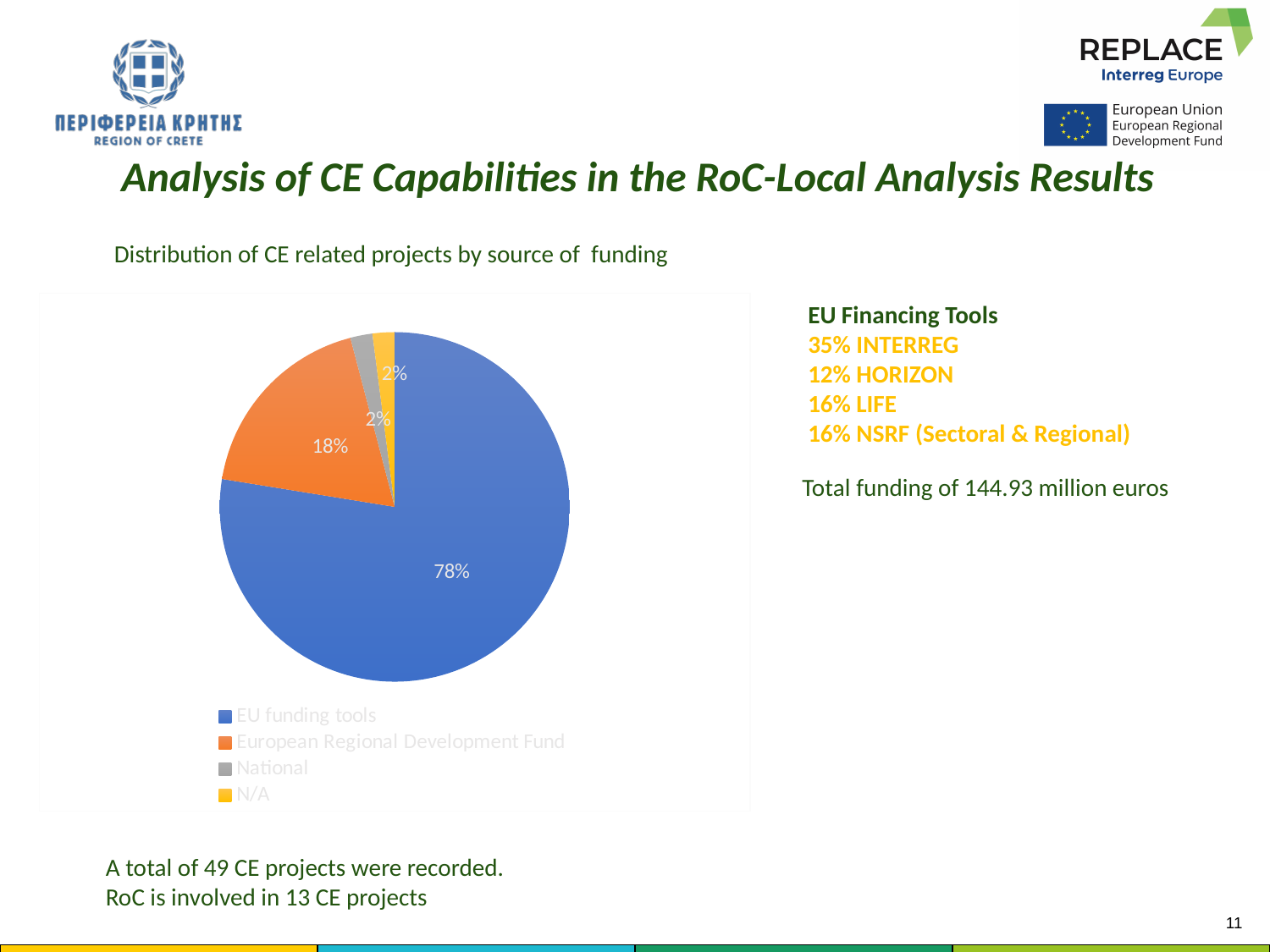
What share of the pie does National account for? 2% How many slices does the pie chart have? 4 What share of the pie does EU funding tools account for? 78% What share of the pie does European Regional Development Fund account for? 18% What type of chart is shown on the slide? pie chart What colour is the EU funding tools slice in the pie chart? blue Which is larger, the European Regional Development Fund slice or the National slice? European Regional Development Fund What is the combined share of the National and N/A slices? 4% How many entries does the legend list? 4 What is the difference in percentage points between the EU funding tools slice and the European Regional Development Fund slice? 60 Which source of funding has the largest slice of the pie? EU funding tools